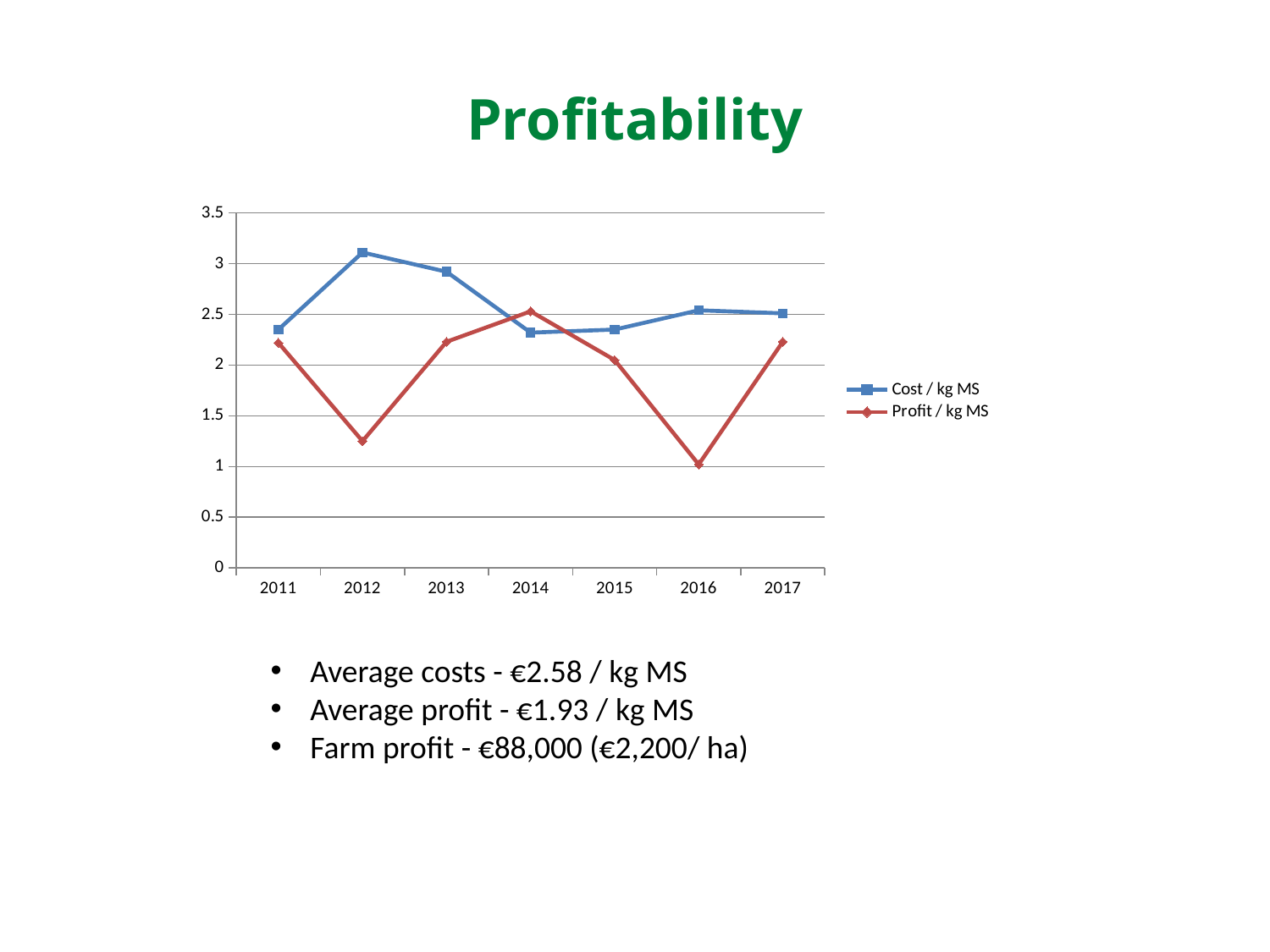
What is the title of the slide containing the chart? Profitability What kind of chart is shown on the slide? Line chart In which year is Profit / kg MS highest? 2014 Is the value for Profit / kg MS in 2011 greater or less than 2? greater Is the value for Profit / kg MS in 2016 greater or less than 1.5? less Is the value for Cost / kg MS in 2012 greater or less than 3? greater In which year is Cost / kg MS highest? 2012 In 2014, which is larger: Cost / kg MS or Profit / kg MS? Profit / kg MS How many years are plotted along the x axis? 7 How many series does the legend list? 2 Does Profit / kg MS rise or fall from 2015 to 2016? Fall In which year is Profit / kg MS lowest? 2016